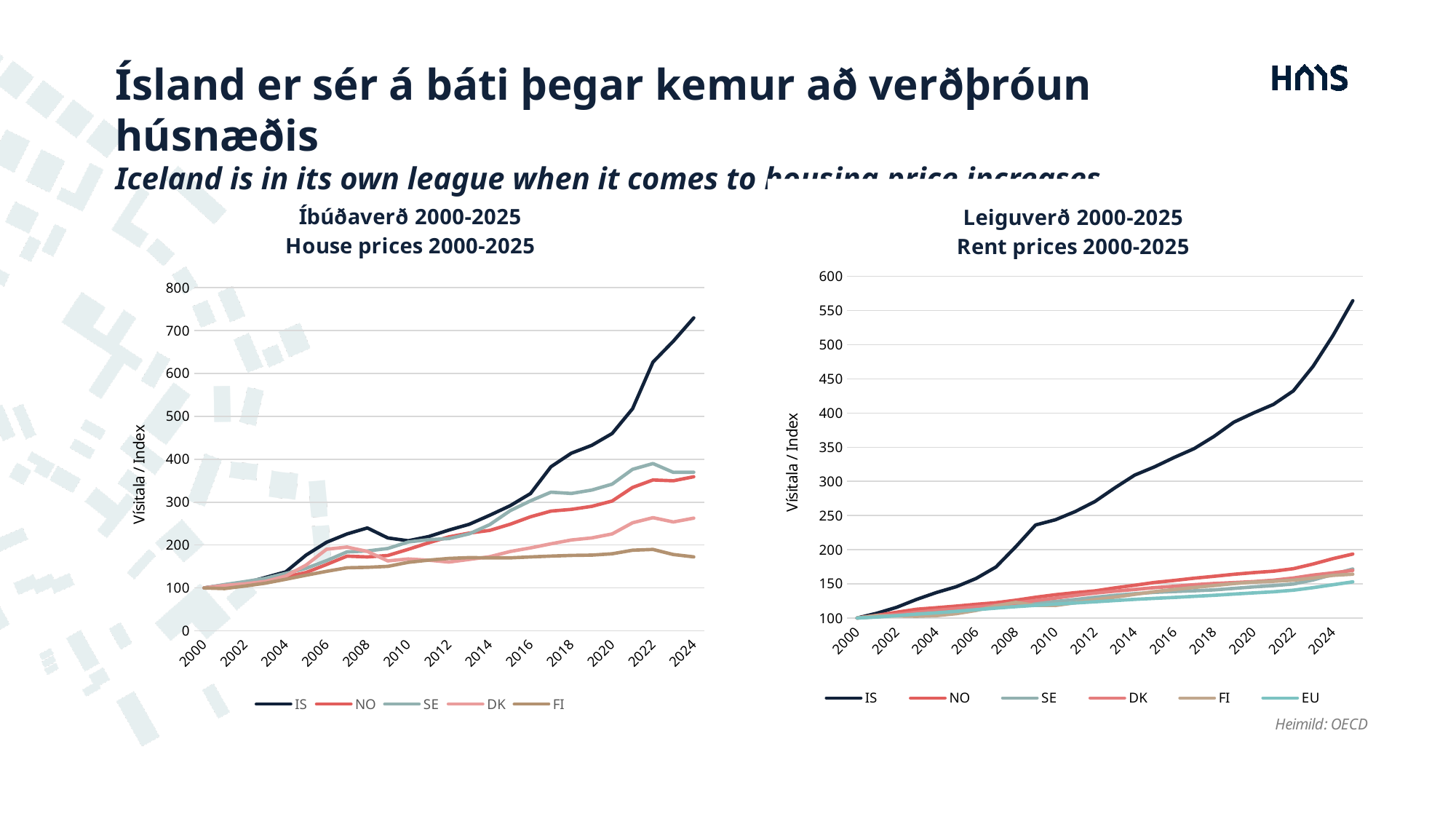
In the House prices 2000-2025 chart, which is higher in 2024, SE or FI? SE How many series does the legend of the Rent prices 2000-2025 chart list? 6 In the Rent prices 2000-2025 chart, which series has the lowest value in 2024? EU What type of chart is the House prices 2000-2025 chart? line chart How many series does the legend of the House prices 2000-2025 chart list? 5 In the House prices 2000-2025 chart, does the IS series rise or fall from 2000 to 2024? rise In the Rent prices 2000-2025 chart, which series has the highest value at the end of the period? IS In the House prices 2000-2025 chart, which series has the lowest value in 2024? FI In the Rent prices 2000-2025 chart, is the value for EU in 2024 greater or less than 200? less In the House prices 2000-2025 chart, is the value for IS in 2024 greater or less than 700? greater In the House prices 2000-2025 chart, which series has the highest value in 2024? IS